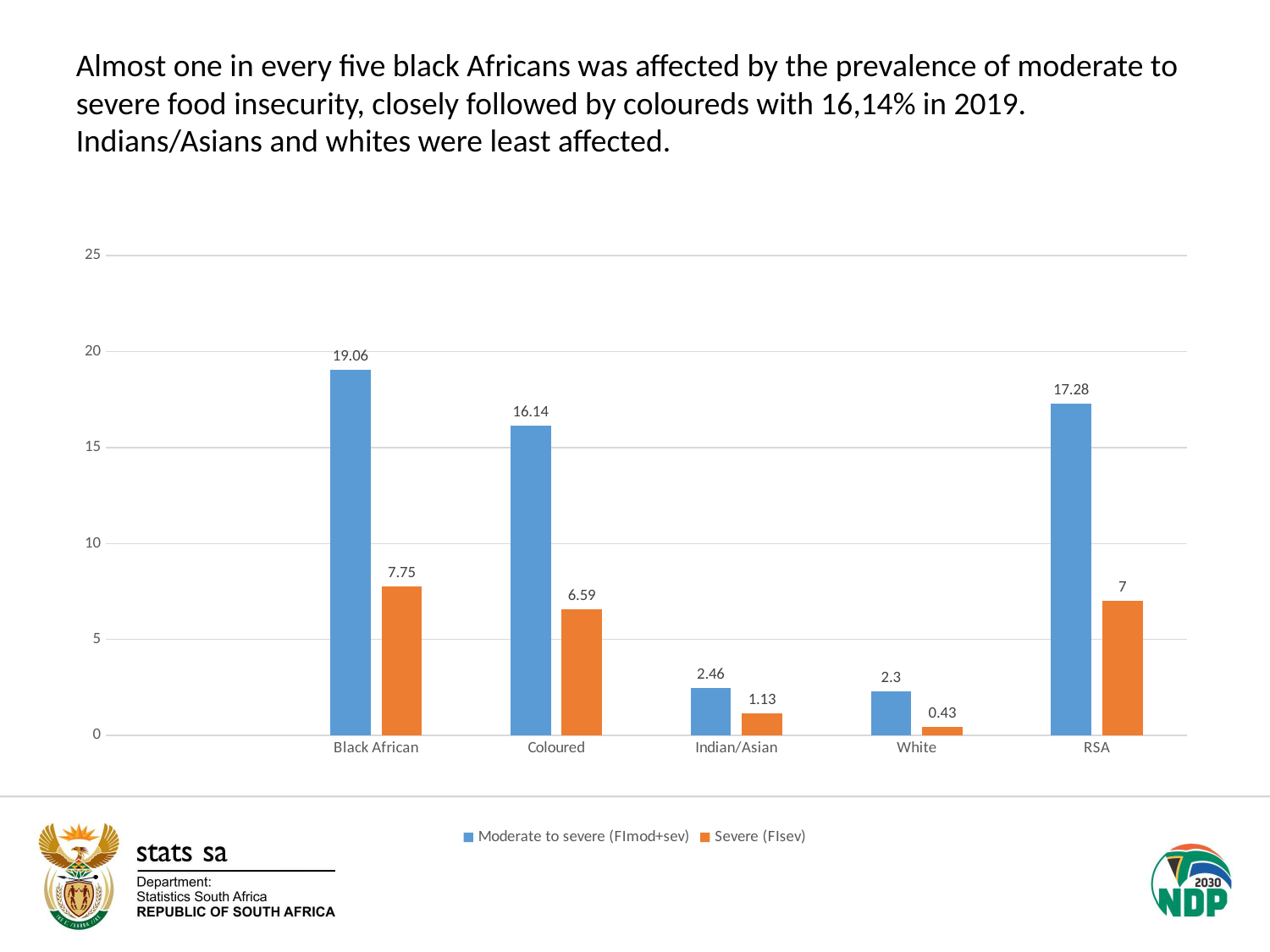
Which category has the lowest Severe (FIsev) value? White Which category has the highest Moderate to severe (FImod+sev) value? Black African What is the Severe (FIsev) value for RSA? 7 What is the Severe (FIsev) value for Coloured? 6.59 Which is larger: the Severe (FIsev) value for Black African or for RSA? Black African What is the Moderate to severe (FImod+sev) value for Black African? 19.06 How many series does the legend list? 2 What is the difference between the Moderate to severe (FImod+sev) values for Black African and Coloured? 2.92 What colour are the Severe (FIsev) bars? orange How many categories are shown on the x axis? 5 Is the Moderate to severe (FImod+sev) value for RSA greater or less than 15? greater What kind of chart is shown on the slide? bar chart